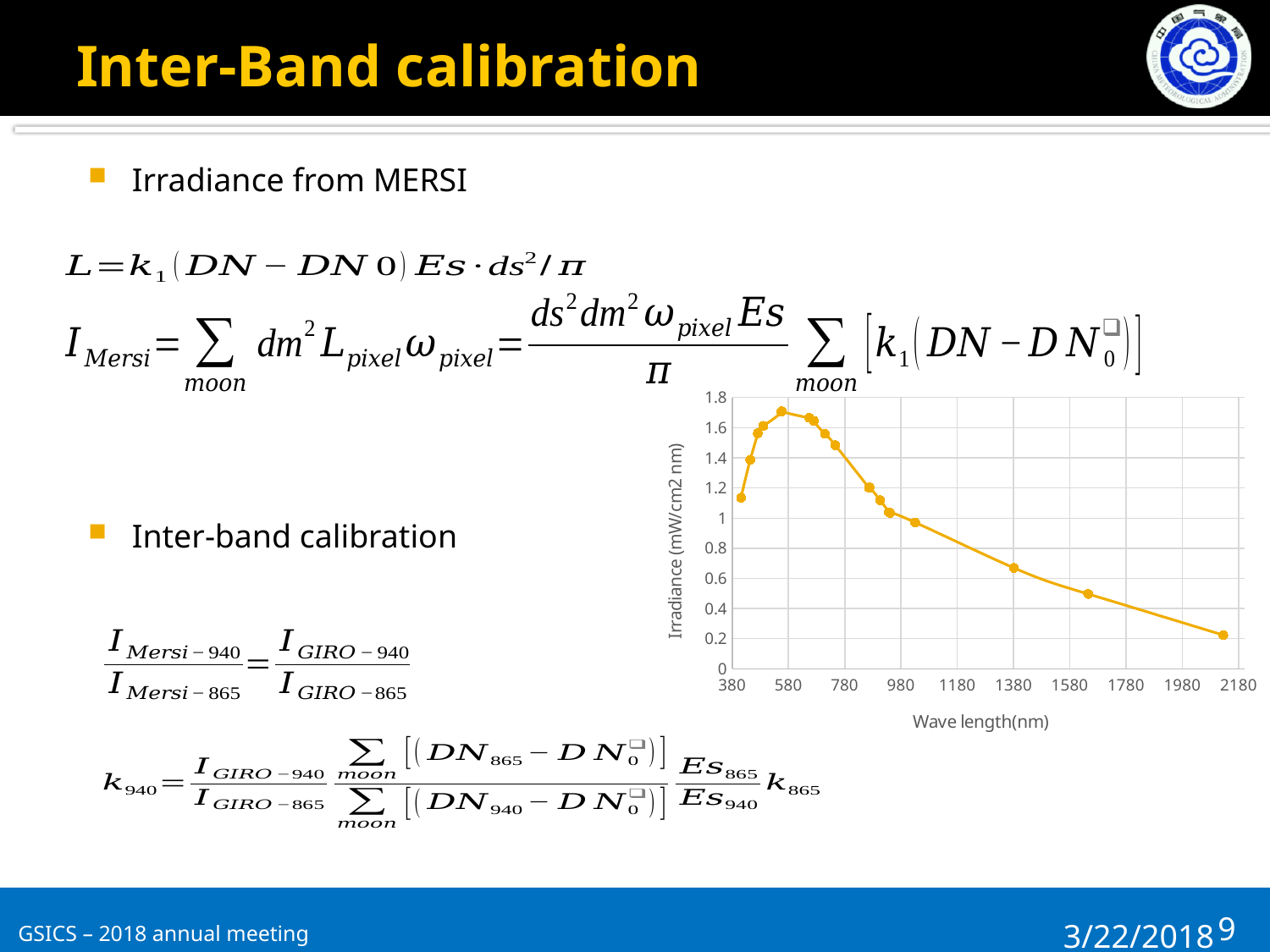
What kind of chart is shown on the slide? line chart What is the largest wavelength tick shown on the horizontal axis? 2180 Which has the larger irradiance: the leftmost point or the rightmost point of the chart? the leftmost point What is the label of the vertical axis of the chart? Irradiance (mW/cm2 nm) Is the irradiance at the rightmost point of the chart greater or less than 0.4? less Is the irradiance at the leftmost point of the chart greater or less than 1? greater Is the irradiance at the point near 1380 nm greater or less than 0.8? less What is the label of the horizontal axis of the chart? Wave length(nm) Does the irradiance rise or fall as wavelength increases beyond about 780 nm? fall How many data series are plotted on the chart? 1